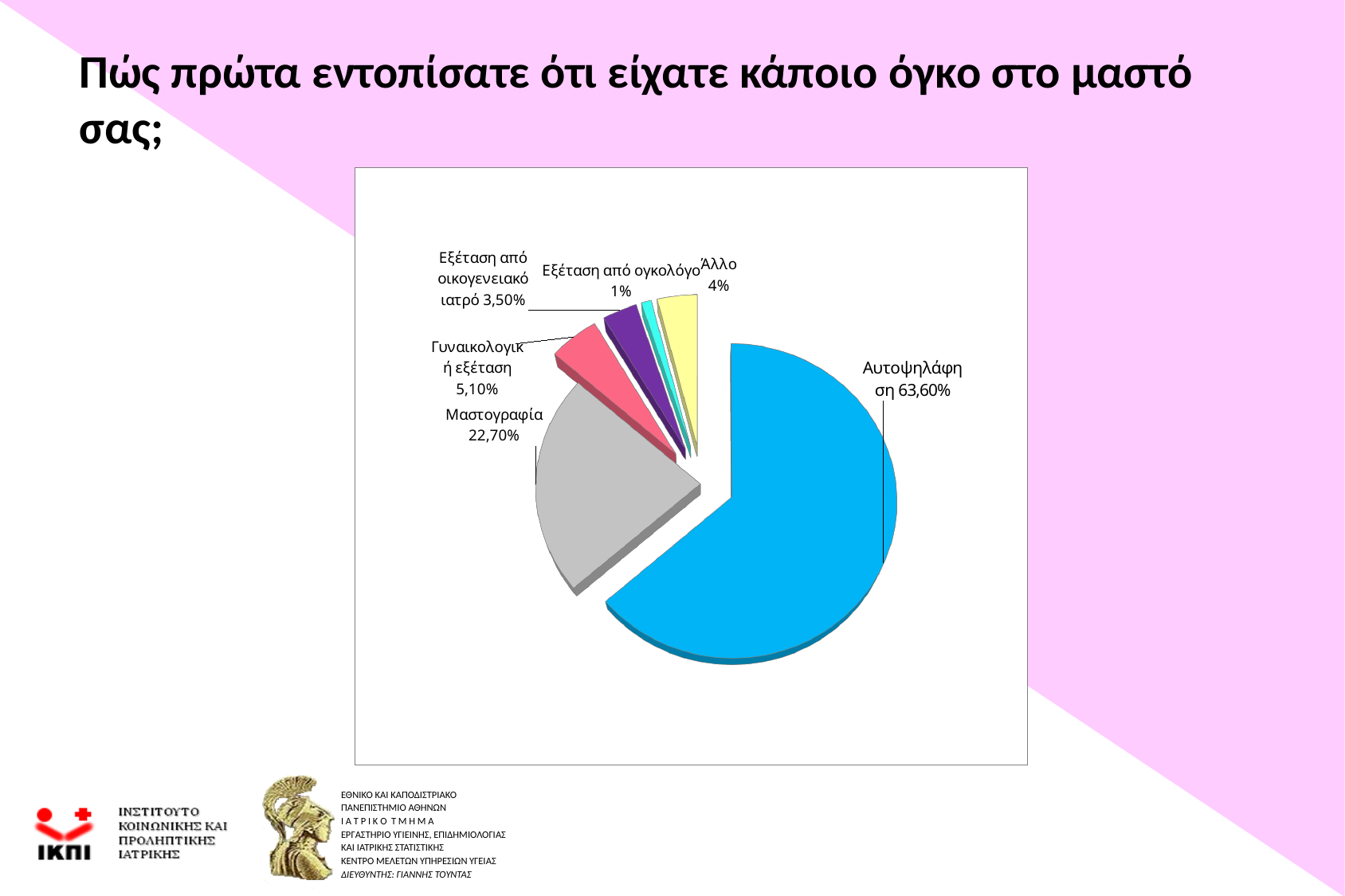
What percentage is shown for Εξέταση από οικογενειακό ιατρό? 3,50% What percentage is shown for Γυναικολογική εξέταση? 5,10% What percentage is shown for Αυτοψηλάφηση? 63,60% What percentage is shown for Άλλο? 4% Which category has the largest share of the pie? Αυτοψηλάφηση Which is larger, the share for Γυναικολογική εξέταση or the share for Άλλο? Γυναικολογική εξέταση How many slices does the pie chart have? 6 What percentage is shown for Μαστογραφία? 22,70% What is the difference in percentage points between Αυτοψηλάφηση and Μαστογραφία? 40,90 Which category has the smallest share of the pie? Εξέταση από ογκολόγο What type of chart is shown on the slide? pie chart What percentage is shown for Εξέταση από ογκολόγο? 1%